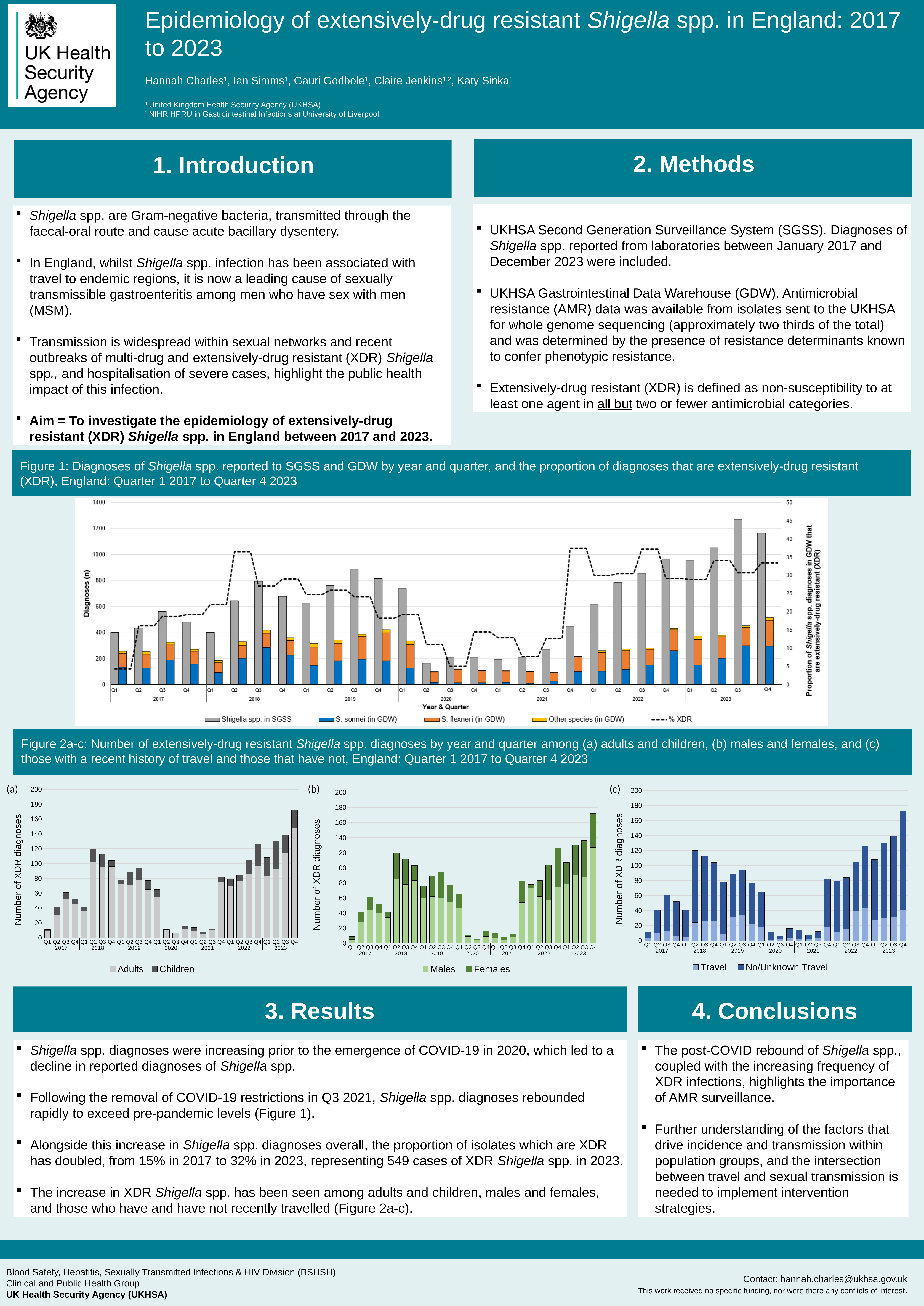
In Figure 1, how many entries does the legend list? 5 In Figure 2b, which quarter has the highest total number of XDR diagnoses? Q4 2023 In Figure 1, which quarter has the lowest number of Shigella spp. diagnoses in SGSS? Q2 2020 In Figure 2c, is the total number of XDR diagnoses for Q4 2023 greater or less than 160? greater In Figure 1, which quarter has the highest number of Shigella spp. diagnoses in SGSS? Q3 2023 In Figure 1, what is the maximum value shown on the left-hand y axis (Diagnoses (n))? 1400 In Figure 1, which series is drawn as a dashed line rather than bars? % XDR In Figure 2a, what are the two series listed in the legend? Adults and Children In Figure 1, which is larger: the Shigella spp. in SGSS bar for Q3 2018 or for Q3 2021? Q3 2018 In Figure 1, is the number of Shigella spp. diagnoses in SGSS for Q2 2020 greater or less than 200? less What kind of chart is Figure 2c? Stacked bar chart In Figure 1, is the number of Shigella spp. diagnoses in SGSS for Q3 2023 greater or less than 1200? greater